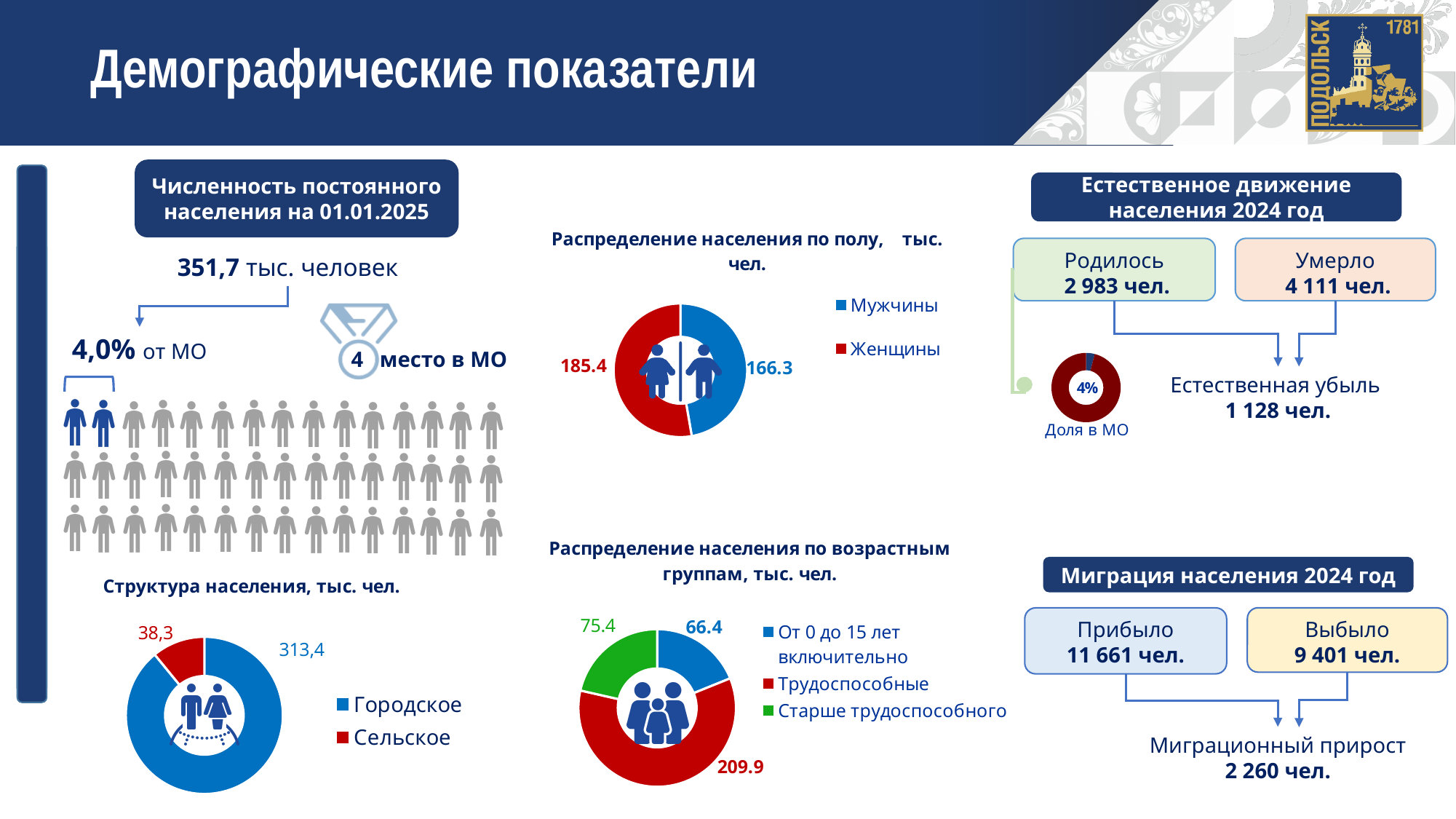
In the chart 'Распределение населения по полу, тыс. чел.', which is larger: Мужчины or Женщины? Женщины How many categories does the legend of the chart 'Распределение населения по возрастным группам, тыс. чел.' list? 3 In the chart 'Распределение населения по возрастным группам, тыс. чел.', which category is the smallest? От 0 до 15 лет включительно In the chart 'Структура населения, тыс. чел.', which category is the largest? Городское In the chart 'Распределение населения по возрастным группам, тыс. чел.', what is the value for Старше трудоспособного? 75.4 In the chart 'Распределение населения по полу, тыс. чел.', what is the value for Мужчины? 166.3 What kind of chart is 'Структура населения, тыс. чел.'? Pie (donut) chart In the chart 'Распределение населения по возрастным группам, тыс. чел.', what is the value for Трудоспособные? 209.9 In the chart 'Структура населения, тыс. чел.', what is the value for Городское? 313,4 In the chart 'Структура населения, тыс. чел.', what is the value for Сельское? 38,3 In the chart 'Распределение населения по полу, тыс. чел.', what is the value for Женщины? 185.4 In the chart 'Распределение населения по полу, тыс. чел.', what is the difference between Женщины and Мужчины? 19.1